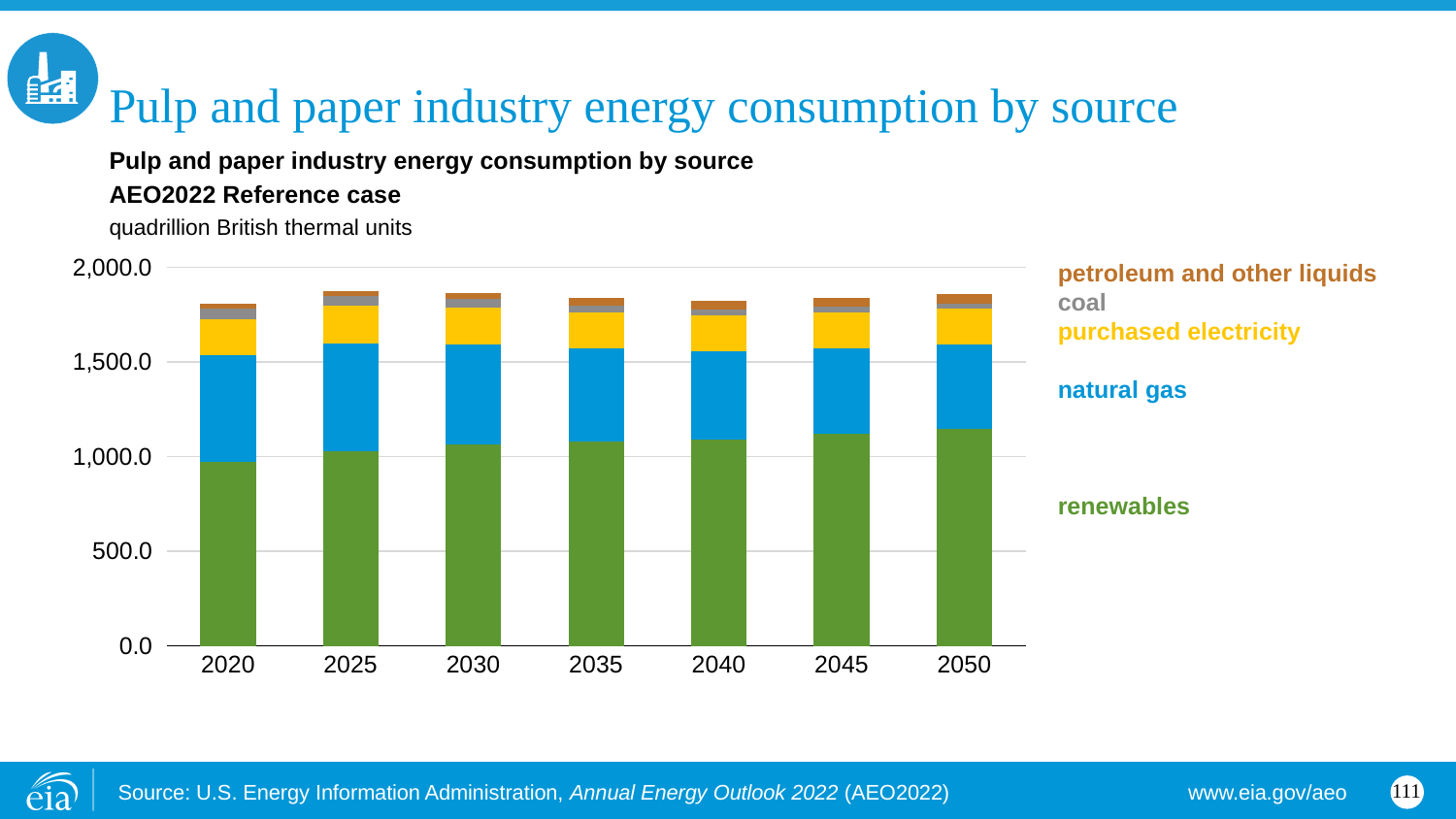
What kind of chart is shown on the slide? stacked bar chart Is the total stacked bar for 2020 greater or less than 2,000.0? less Is the total stacked bar for 2025 greater or less than 1,500.0? greater What unit is the chart measured in? quadrillion British thermal units How many years are shown along the x axis of the chart? 7 Which energy source is shown in blue? natural gas Is the renewables value larger in 2020 or in 2050? 2050 Is the renewables value for 2050 greater or less than 1,000.0? greater How many energy sources does the legend list? 5 Does the renewables segment rise or fall from 2020 to 2050? rise Which energy source makes up the largest segment of each bar? renewables